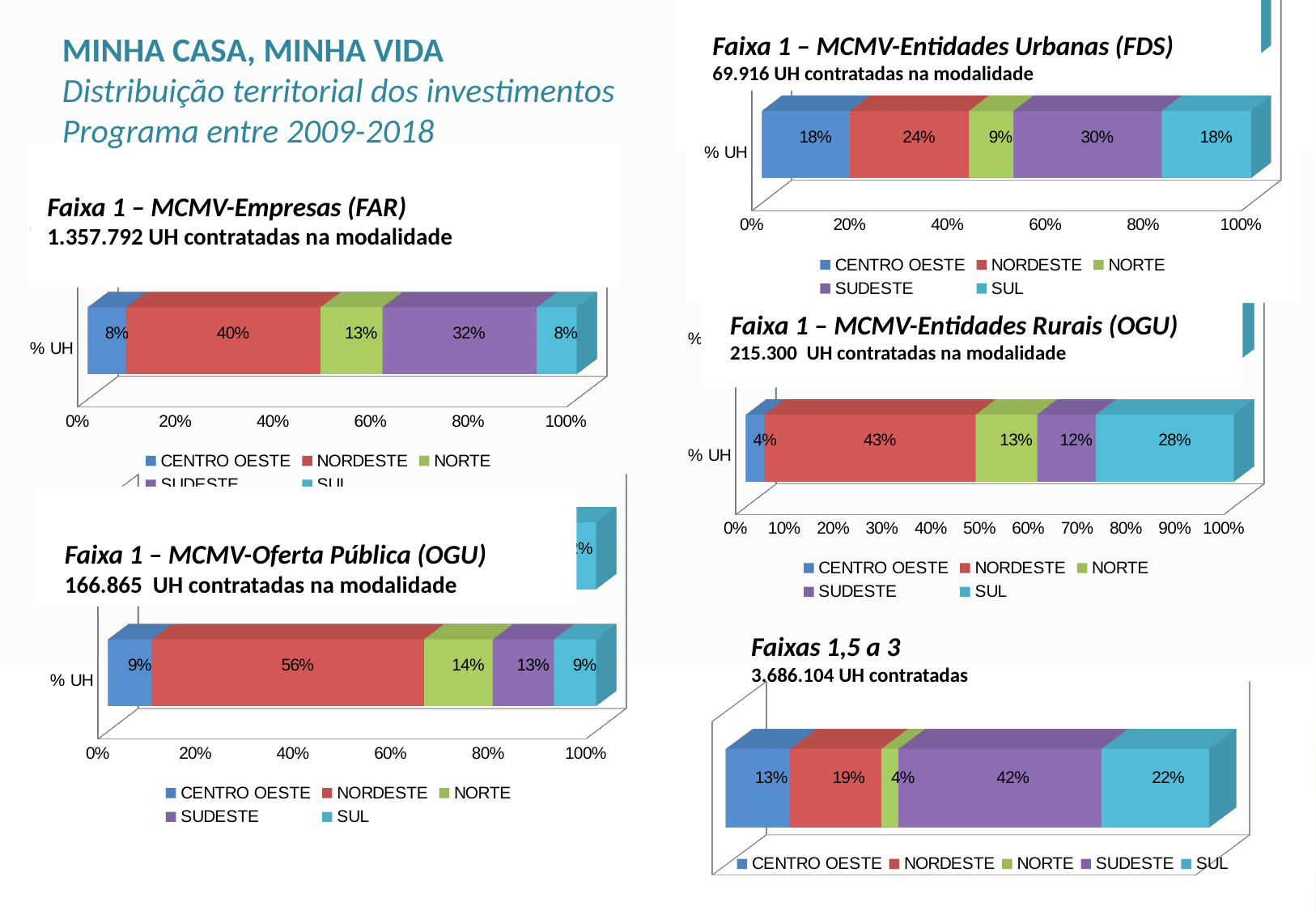
In the 'Faixa 1 – MCMV-Entidades Rurais (OGU)' chart, what is the difference between NORDESTE and SUL? 15% In the 'Faixa 1 – MCMV-Oferta Pública (OGU)' chart, which is larger, NORTE or SUDESTE? NORTE In the 'Faixa 1 – MCMV-Entidades Urbanas (FDS)' chart, what is the value for SUDESTE? 30% In the 'Faixa 1 – MCMV-Empresas (FAR)' chart, what is the value for NORDESTE? 40% In the 'Faixa 1 – MCMV-Entidades Urbanas (FDS)' chart, which region has the lowest share? NORTE In the 'Faixas 1,5 a 3' chart, what is the value for SUDESTE? 42% What kind of chart is the 'Faixa 1 – MCMV-Empresas (FAR)' chart? Stacked bar chart In the 'Faixa 1 – MCMV-Oferta Pública (OGU)' chart, what is the value for NORDESTE? 56% In the 'Faixa 1 – MCMV-Entidades Rurais (OGU)' chart, what is the value for SUL? 28% How many series does the legend of the 'Faixas 1,5 a 3' chart list? 5 In the 'Faixa 1 – MCMV-Empresas (FAR)' chart, which region has the highest share? NORDESTE In the 'Faixas 1,5 a 3' chart, which region has the lowest share? NORTE